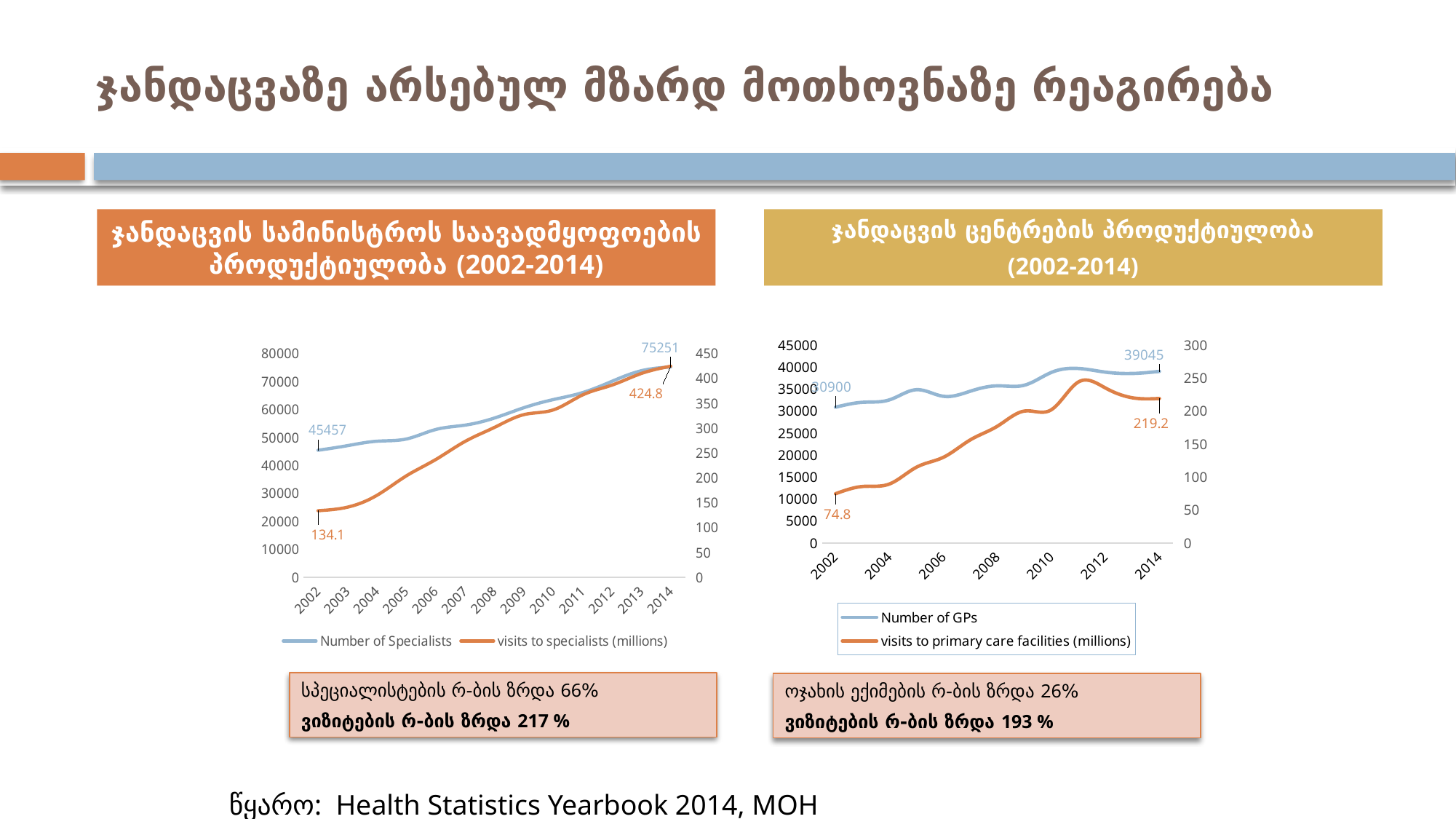
In the right chart, does the Number of GPs rise or fall overall from 2002 to 2014? rise In the right chart, by how much did visits to primary care facilities (millions) increase from 2002 to 2014? 144.4 How many series does the legend of the right chart list? 2 In the right chart, what is the value of visits to primary care facilities (millions) in 2002? 74.8 What kind of chart is the left chart? line chart In the left chart, what is the value of visits to specialists (millions) in 2014? 424.8 In the right chart, what is the Number of GPs in 2014? 39045 In the left chart, by how much did visits to specialists (millions) increase from 2002 to 2014? 290.7 In the left chart, what is the Number of Specialists in 2014? 75251 In the left chart, by how much did the Number of Specialists increase from 2002 to 2014? 29794 In the left chart, what is the Number of Specialists in 2002? 45457 In the right chart, is the Number of GPs in 2002 greater or less than 35000? less